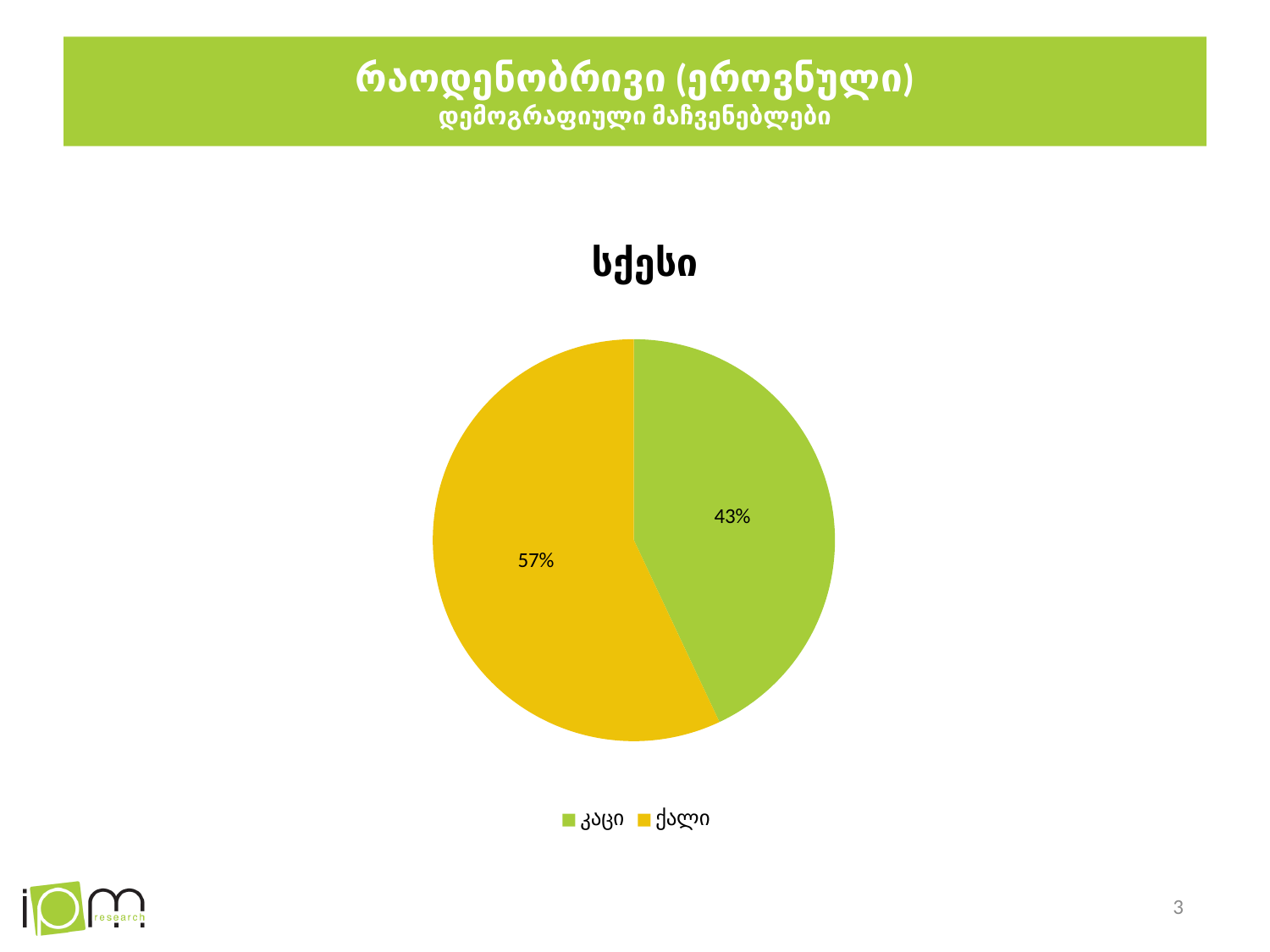
Which category has the largest share of the pie? ქალი Which is larger, the share for კაცი or the share for ქალი? ქალი Which category has the smallest share of the pie? კაცი How many slices does the pie chart have? 2 How many entries does the legend list? 2 What colour is the slice for ქალი? yellow What share of the pie does კაცი represent? 43% What share of the pie does ქალი represent? 57% What is the difference in percentage points between ქალი and კაცი? 14 What type of chart is shown on the slide? pie chart What is the title of the chart? სქესი